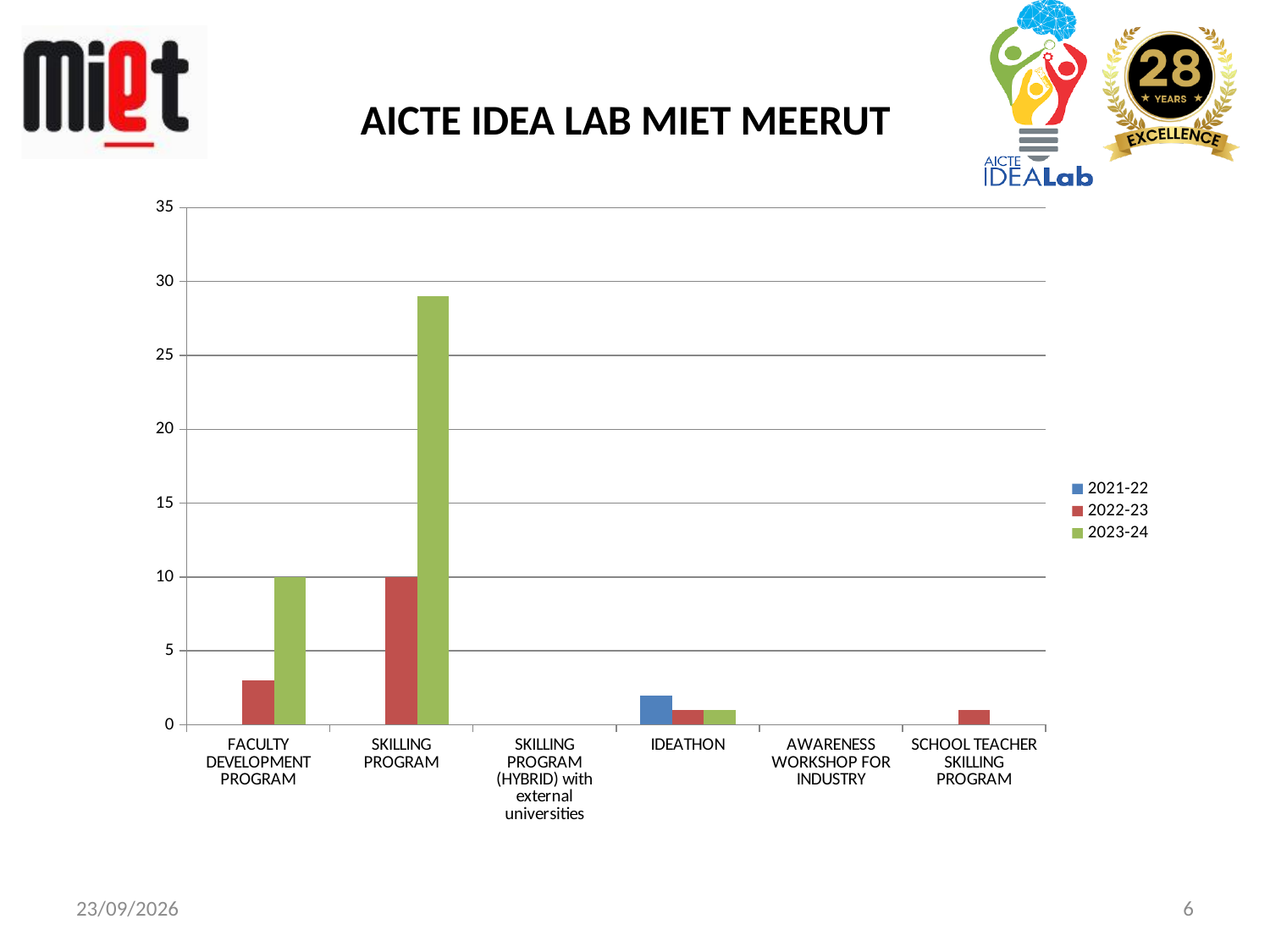
Is the value for FACULTY DEVELOPMENT PROGRAM in the 2022-23 series greater or less than 5? less Which is larger: the 2023-24 value for SKILLING PROGRAM or the 2023-24 value for FACULTY DEVELOPMENT PROGRAM? SKILLING PROGRAM Which category is the only one with a bar in the 2021-22 series? IDEATHON What is the value for FACULTY DEVELOPMENT PROGRAM in the 2023-24 series? 10 Which category has the highest value in the 2023-24 series? SKILLING PROGRAM Is the value for SKILLING PROGRAM in the 2023-24 series greater or less than 25? greater How many categories are shown on the x axis? 6 How many series does the legend list? 3 Is the value for IDEATHON in the 2021-22 series greater or less than 5? less What kind of chart is shown on the slide? bar chart What is the value for SKILLING PROGRAM in the 2022-23 series? 10 What is the title of the chart? AICTE IDEA LAB MIET MEERUT